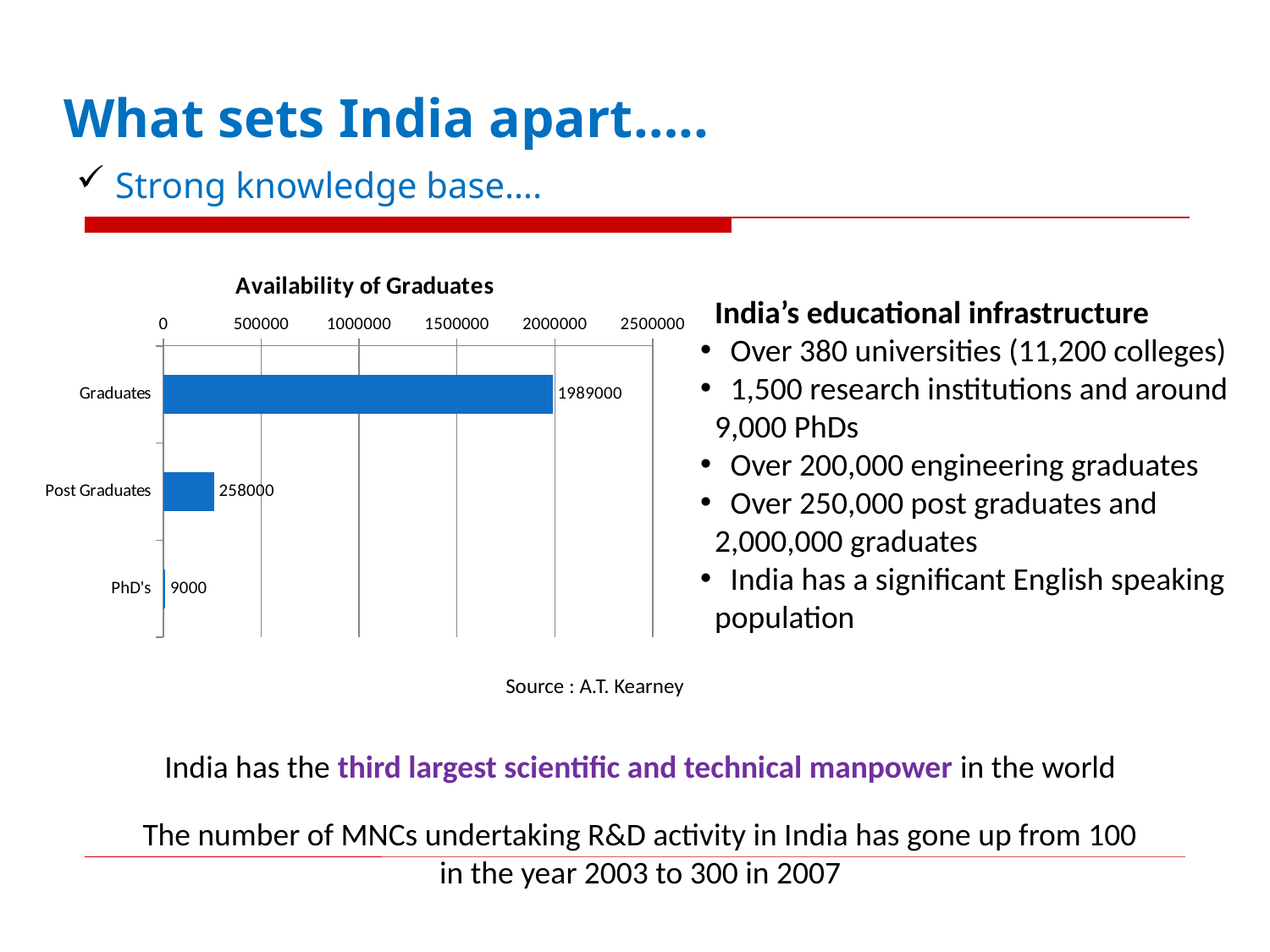
Is the value for Graduates greater or less than 1500000 in the Availability of Graduates chart? greater What is the difference between the Graduates and Post Graduates values in the Availability of Graduates chart? 1731000 What is the title of the chart on the slide? Availability of Graduates What is the value for Post Graduates in the Availability of Graduates chart? 258000 Which category has the highest value in the Availability of Graduates chart? Graduates Which is larger in the Availability of Graduates chart, Post Graduates or PhD's? Post Graduates What is the value for PhD's in the Availability of Graduates chart? 9000 Which category has the lowest value in the Availability of Graduates chart? PhD's What is the difference between the Post Graduates and PhD's values in the Availability of Graduates chart? 249000 What kind of chart is the Availability of Graduates chart? Bar chart What is the value for Graduates in the Availability of Graduates chart? 1989000 How many categories are shown in the Availability of Graduates chart? 3